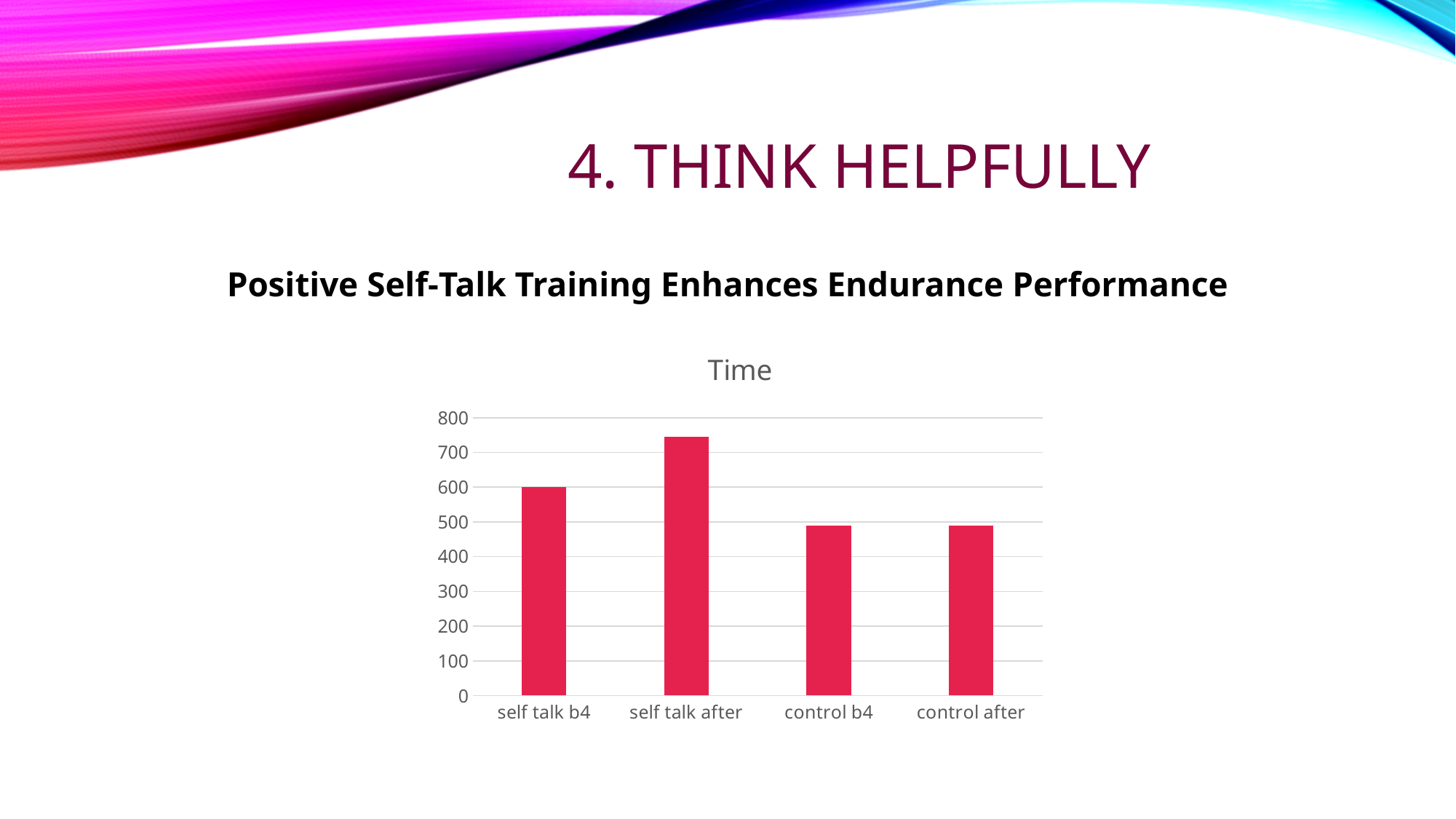
Is the value for self talk b4 greater or less than 500? greater What is the title of the chart? Time Is the value for self talk after greater or less than 700? greater What kind of chart is shown on the slide? bar chart Which is larger, the value for self talk after or the value for self talk b4? self talk after What is the highest value shown on the vertical axis of the chart? 800 How many categories are shown on the x axis of the chart? 4 What is the value for self talk b4? 600 Which category has the highest value in the chart? self talk after Which is larger, the value for self talk b4 or the value for control b4? self talk b4